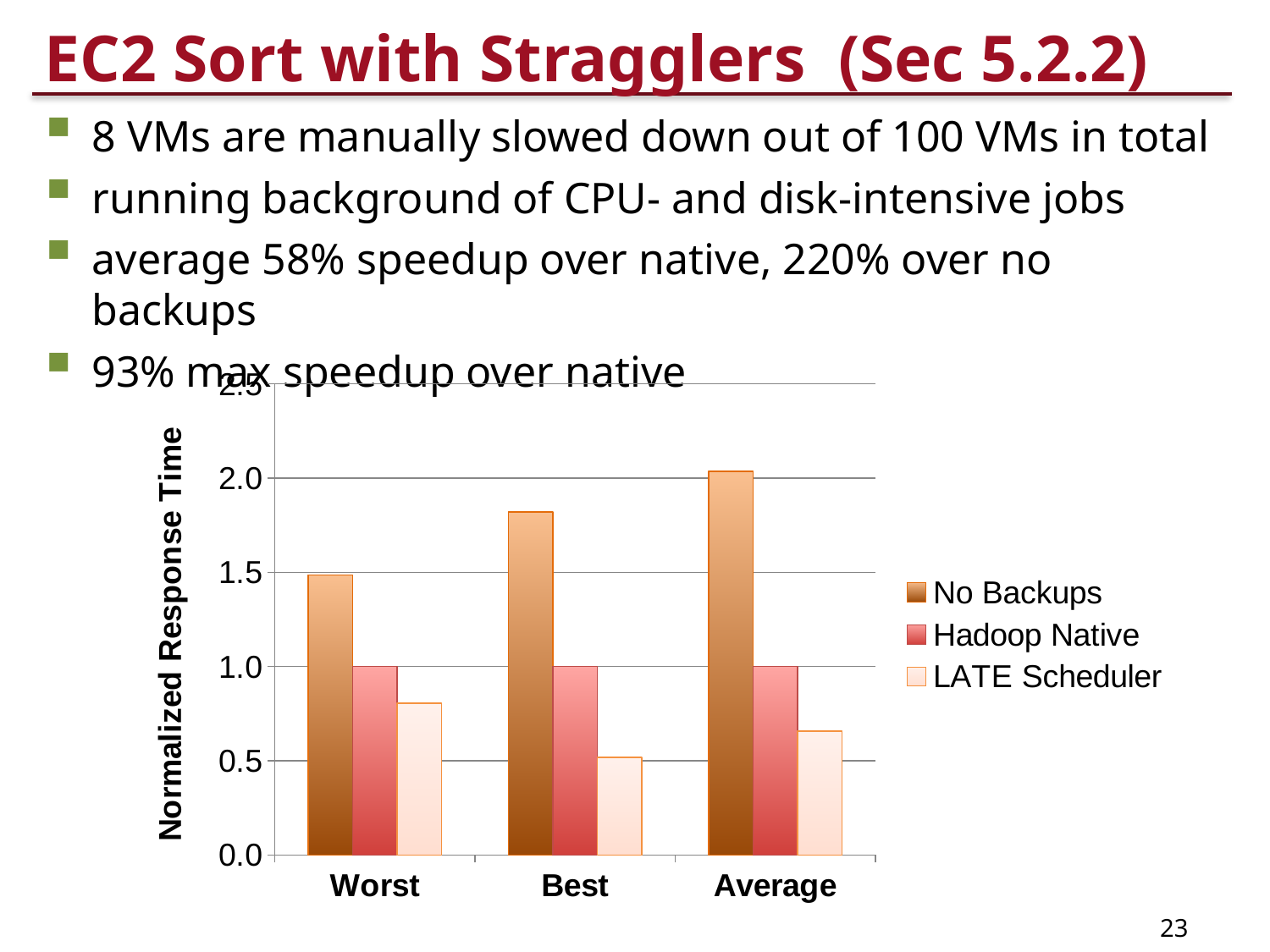
What is the label of the y axis of the chart? Normalized Response Time Is the LATE Scheduler value for Average greater or less than 0.5? greater Which is larger, the No Backups value for Best or the No Backups value for Worst? Best What is the Normalized Response Time for Hadoop Native in the Average category? 1.0 Is the No Backups value for Best greater or less than 1.5? greater How many categories are shown on the x axis of the chart? 3 Is the LATE Scheduler value for Worst greater or less than 1.0? less What is the Normalized Response Time for Hadoop Native in the Worst category? 1.0 How many series does the chart legend list? 3 Which category has the lowest LATE Scheduler bar? Best What kind of chart is shown on the slide? bar chart Which category has the highest No Backups bar? Average